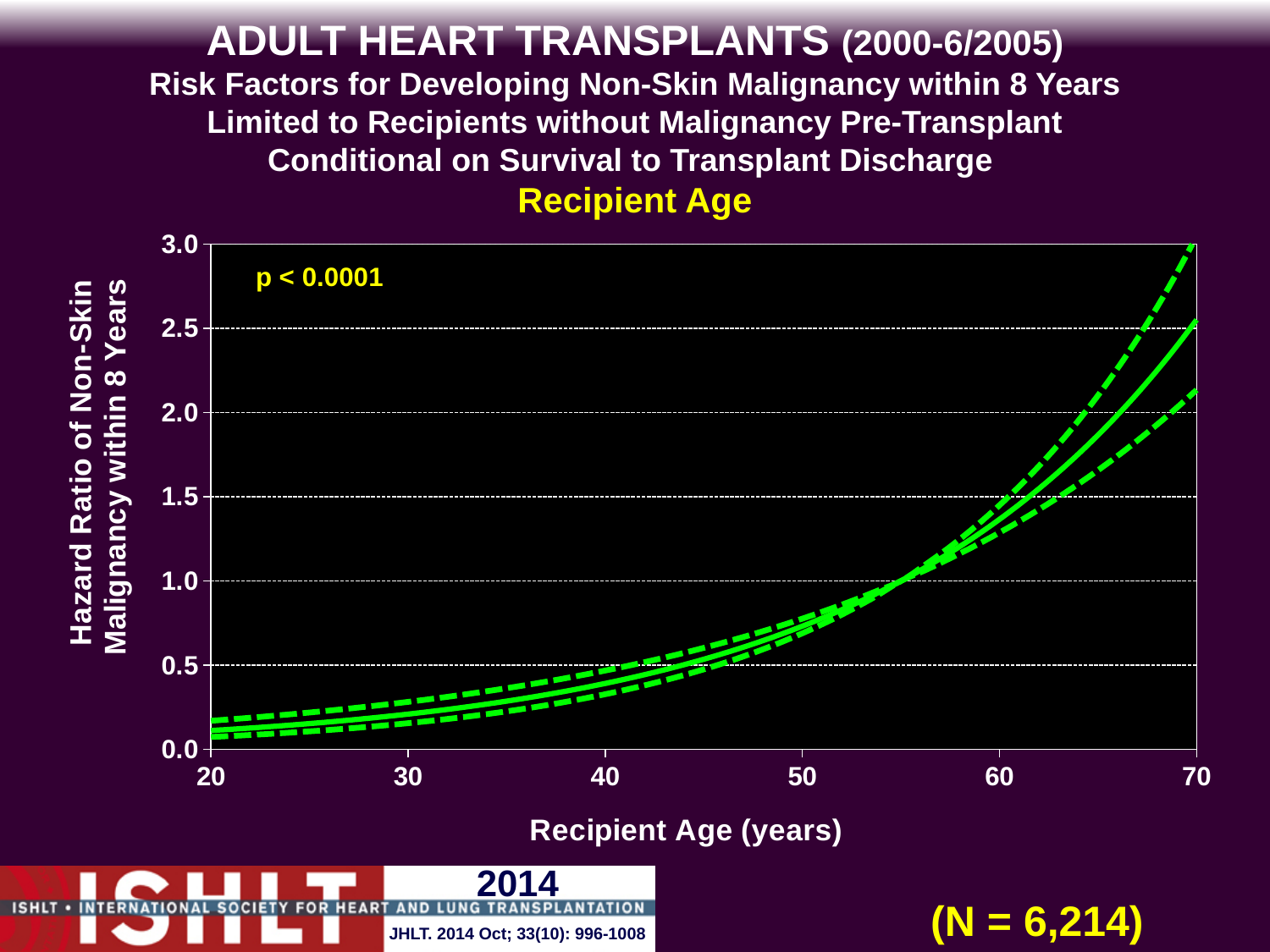
Is the hazard ratio on the solid line at recipient age 70 greater or less than 2.0? greater Is the hazard ratio on the solid line at recipient age 20 greater or less than 0.5? less What kind of chart is shown on the slide? line chart Which recipient age has the higher hazard ratio on the solid line, 30 or 60? 60 What p-value is printed on the chart? p < 0.0001 Is the hazard ratio on the solid line at recipient age 60 greater or less than 1.0? greater Does the hazard ratio rise or fall as recipient age increases from 20 to 70 years? rise How many lines (solid and dashed) are plotted on the chart? 3 What is the label of the x axis? Recipient Age (years)